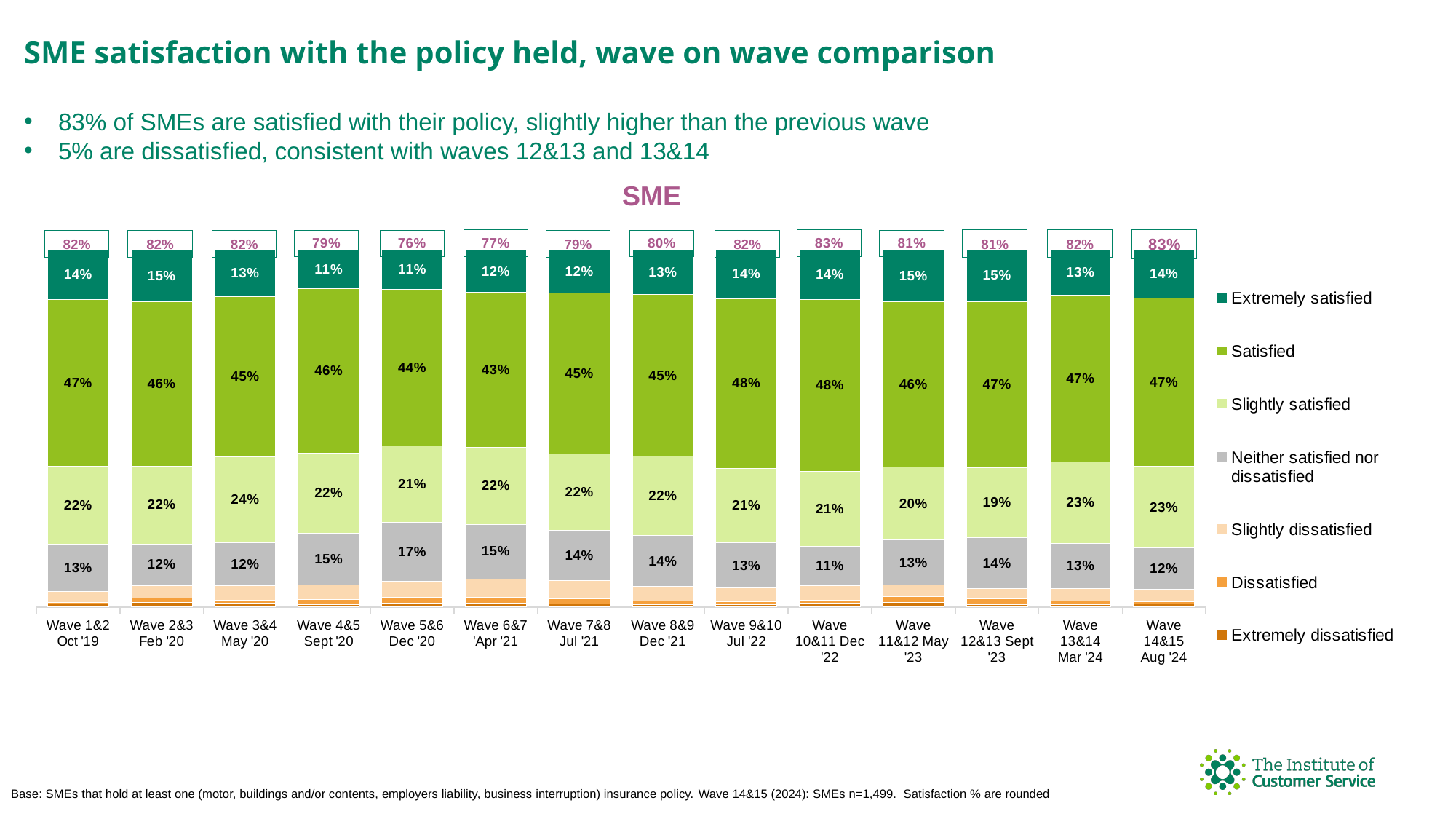
How many waves are shown on the x axis of the chart? 14 Which wave has the highest 'Slightly satisfied' value? Wave 3&4 May '20 What percentage of SMEs were 'Satisfied' in Wave 14&15 Aug '24? 47% How many series does the chart legend list? 7 Which wave has the lowest 'Satisfied' value? Wave 6&7 'Apr '21 What is the overall satisfaction percentage shown above the bar for Wave 4&5 Sept '20? 79% Which wave has the lowest overall satisfaction percentage shown above the bars? Wave 5&6 Dec '20 Which wave has the highest 'Neither satisfied nor dissatisfied' value? Wave 5&6 Dec '20 What is the difference in the 'Satisfied' percentage between Wave 1&2 Oct '19 and Wave 6&7 'Apr '21? 4 percentage points What is the 'Neither satisfied nor dissatisfied' value for Wave 5&6 Dec '20? 17% Is the 'Extremely satisfied' value higher in Wave 2&3 Feb '20 or Wave 4&5 Sept '20? Wave 2&3 Feb '20 What type of chart is used on the slide? Stacked bar chart